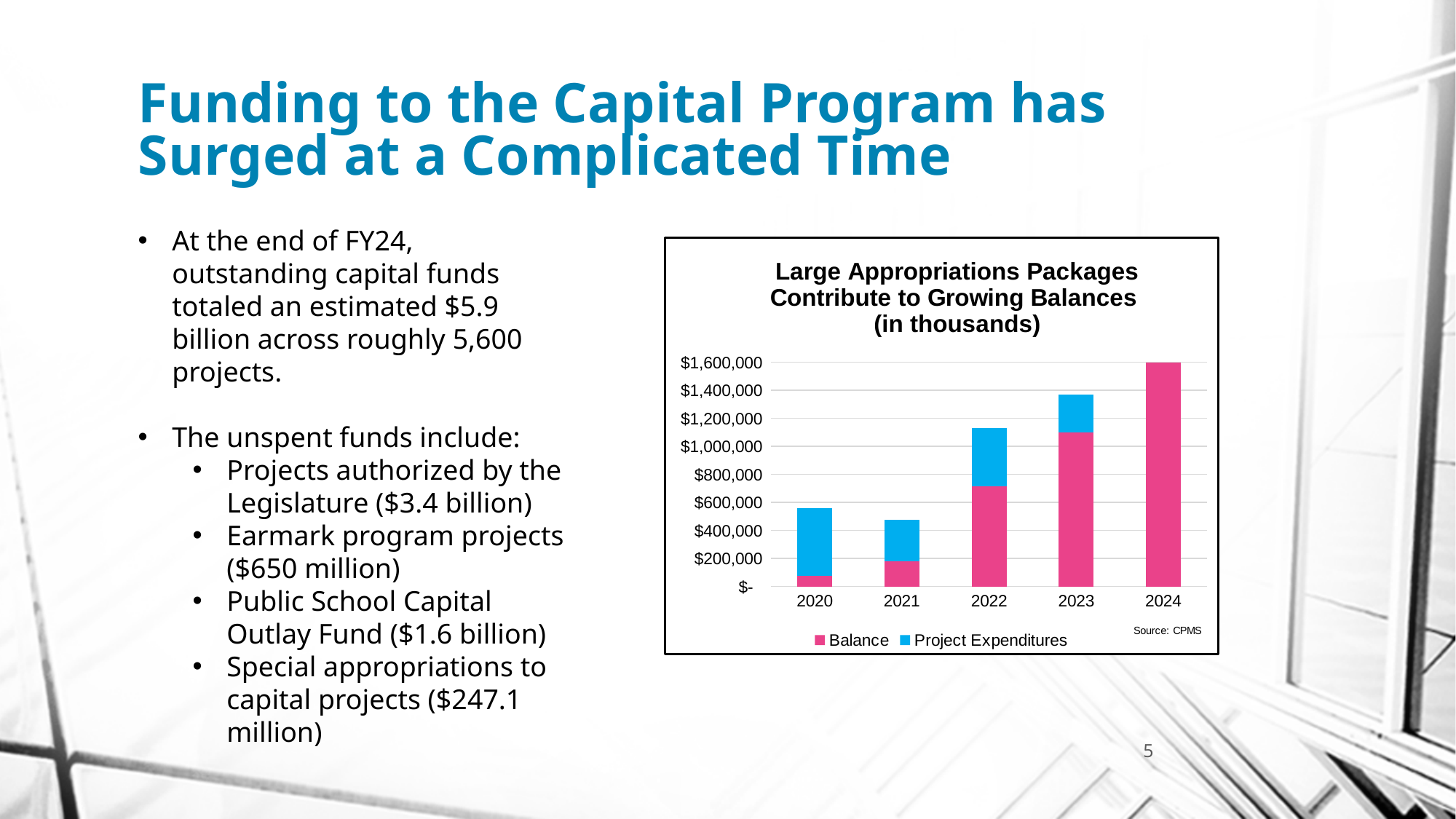
Is the Balance value for 2022 greater or less than $600,000? greater Is the total bar for 2021 greater or less than $600,000? less How many series does the chart legend list? 2 Which year has the tallest total bar in the chart? 2024 How many years are shown on the x axis of the chart? 5 What kind of chart is shown on the slide? Stacked bar chart Which year has the shortest total bar in the chart? 2021 Does the Balance series rise or fall from 2020 to 2024? Rises Is the total bar for 2024 greater or less than $1,400,000? greater Which colour represents Project Expenditures in the chart? Blue Which year has the larger Balance value, 2022 or 2023? 2023